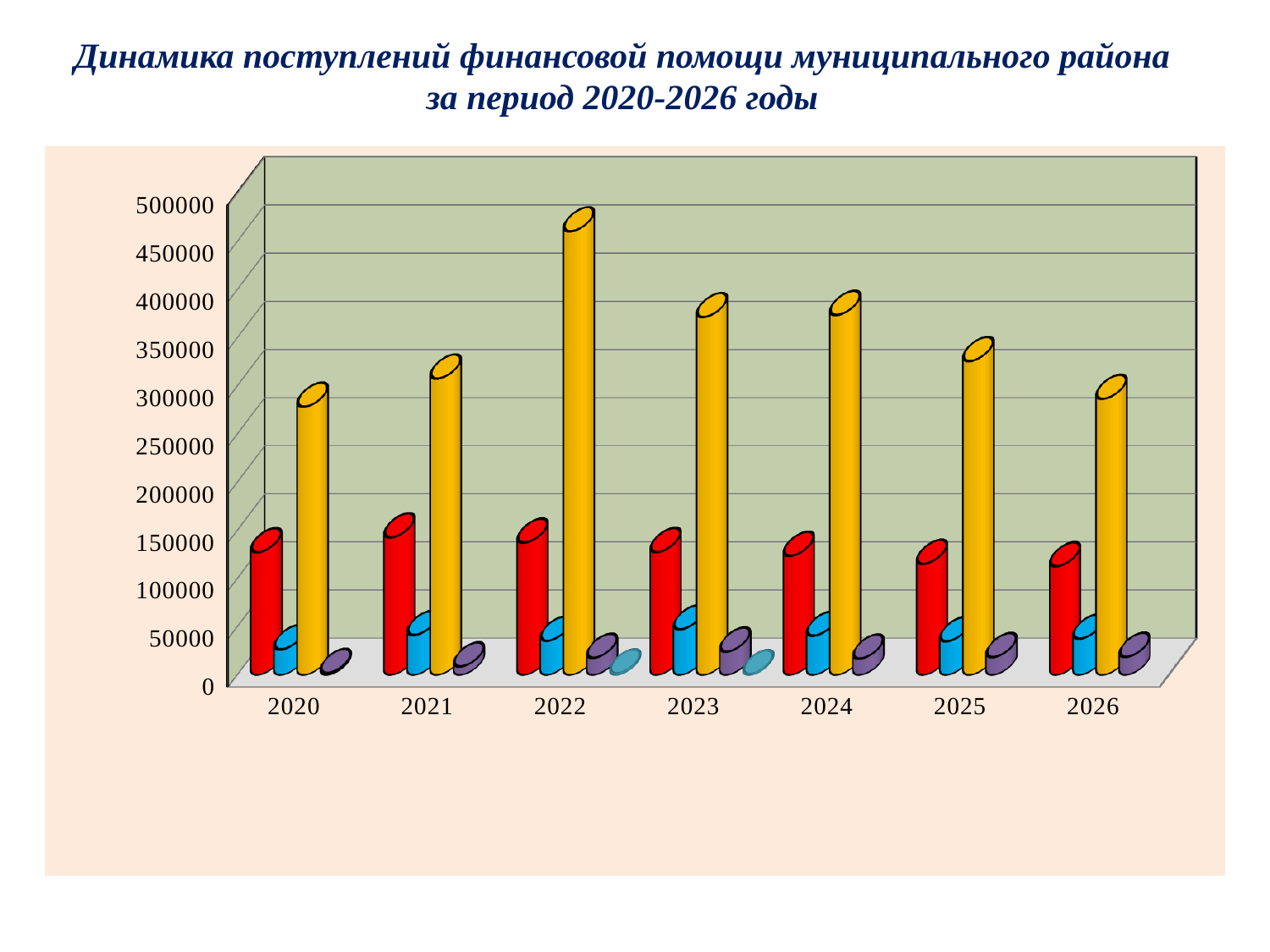
Is the value of the blue bar for 2023 greater or less than 100000? less Which is larger in 2020, the red bar or the yellow bar? the yellow bar Is the value of the yellow bar for 2020 greater or less than 350000? less What period does the chart title say the data covers? 2020-2026 годы Which is larger, the yellow bar for 2022 or the yellow bar for 2023? 2022 Is the value of the red bar for 2021 greater or less than 100000? greater Do the yellow bars rise or fall from 2022 to 2026? fall How many years are shown along the x axis of the chart? 7 What kind of chart is shown on the slide? bar chart In which year is the yellow bar the tallest? 2022 In which year is the red bar the tallest? 2021